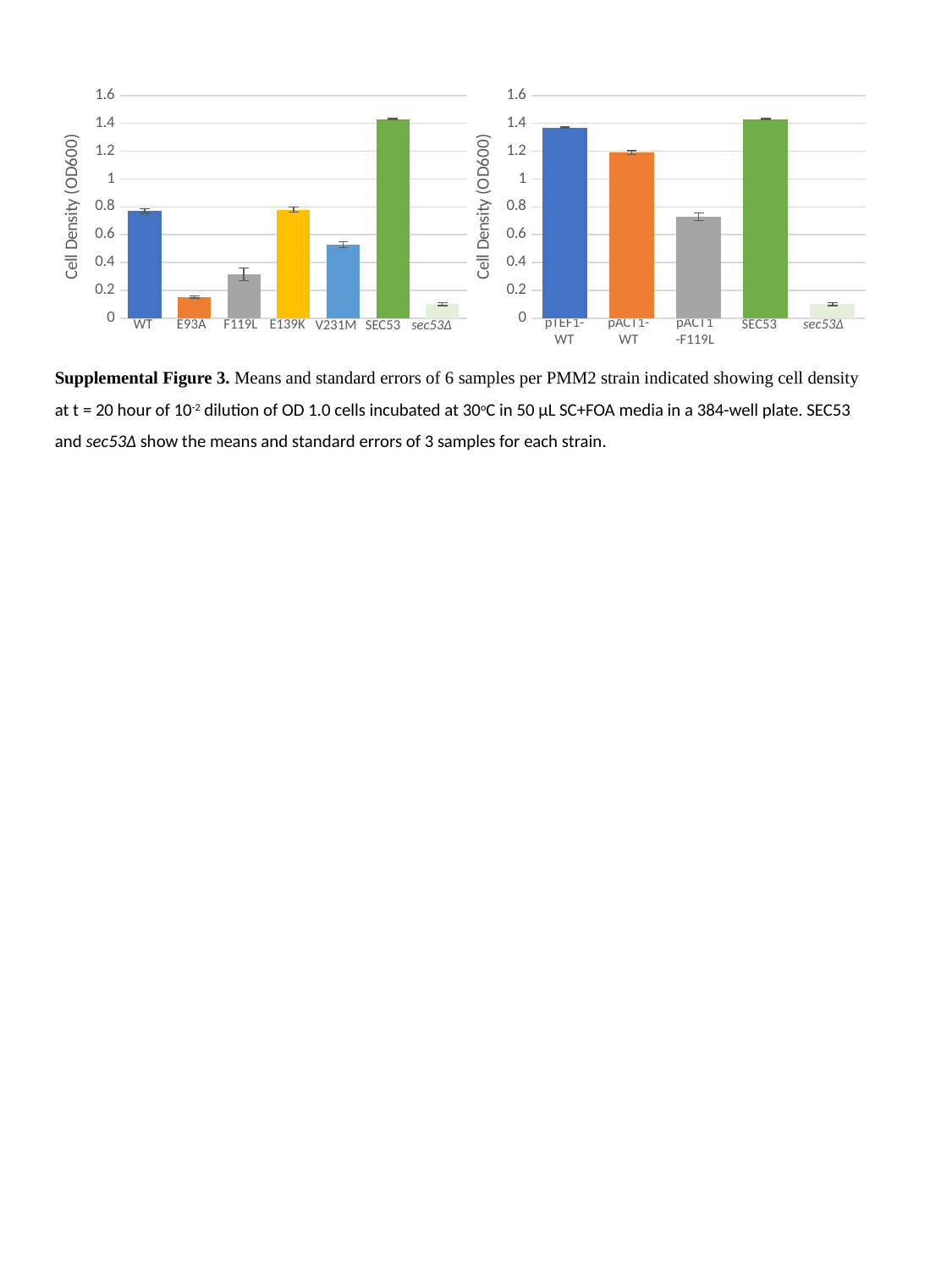
What kind of chart is the left chart? bar chart In the left chart, is the value for SEC53 greater or less than 1.2? greater In the right chart, how many strains are plotted along the x axis? 5 In the right chart, which strain has the highest cell density? SEC53 In the left chart, is the value for E93A greater or less than 0.2? less In the left chart, which strain has the highest cell density? SEC53 In the left chart, which strain has the lowest cell density? sec53Δ In the right chart, which strain has the lowest cell density? sec53Δ In the left chart, how many strains are plotted along the x axis? 7 In the left chart, which has the larger cell density, F119L or V231M? V231M In the right chart, is the value for pACT1-F119L greater or less than 0.8? less What is the y-axis label of the right chart? Cell Density (OD600)